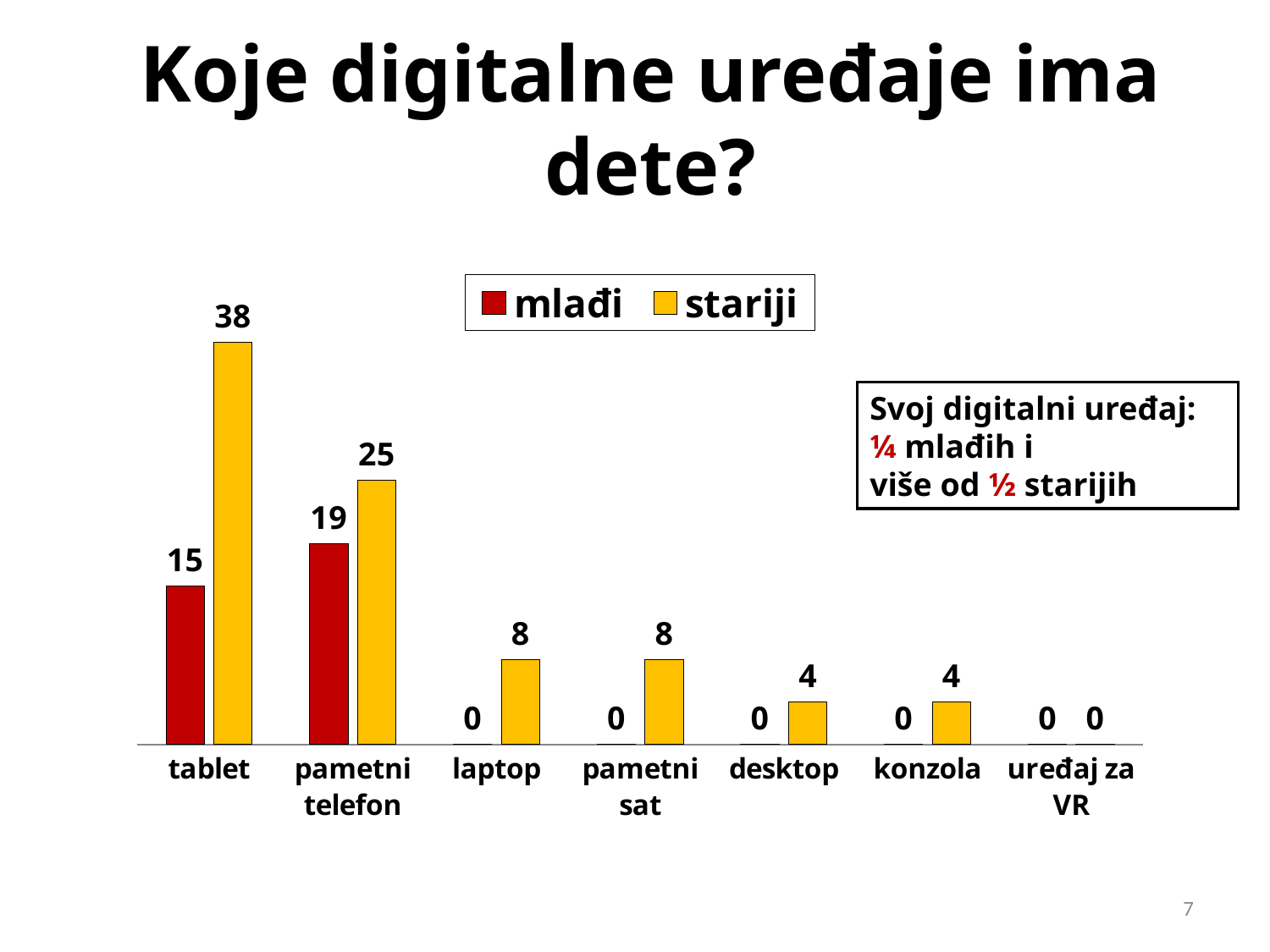
What is the value for 'mlađi' in the 'pametni telefon' category? 19 What kind of chart is shown on the slide? bar chart How many series does the legend list? 2 What is the value for 'stariji' in the 'tablet' category? 38 How many categories are shown on the x axis? 7 Which category has the highest value for the 'stariji' series? tablet Which colour represents the 'mlađi' series? red Which is larger: the 'mlađi' value for 'tablet' or the 'mlađi' value for 'pametni telefon'? pametni telefon What is the difference between the 'stariji' values for 'pametni telefon' and 'desktop'? 21 What is the value for 'stariji' in the 'laptop' category? 8 Which category has the highest value for the 'mlađi' series? pametni telefon What is the difference between the 'stariji' and 'mlađi' values for 'tablet'? 23